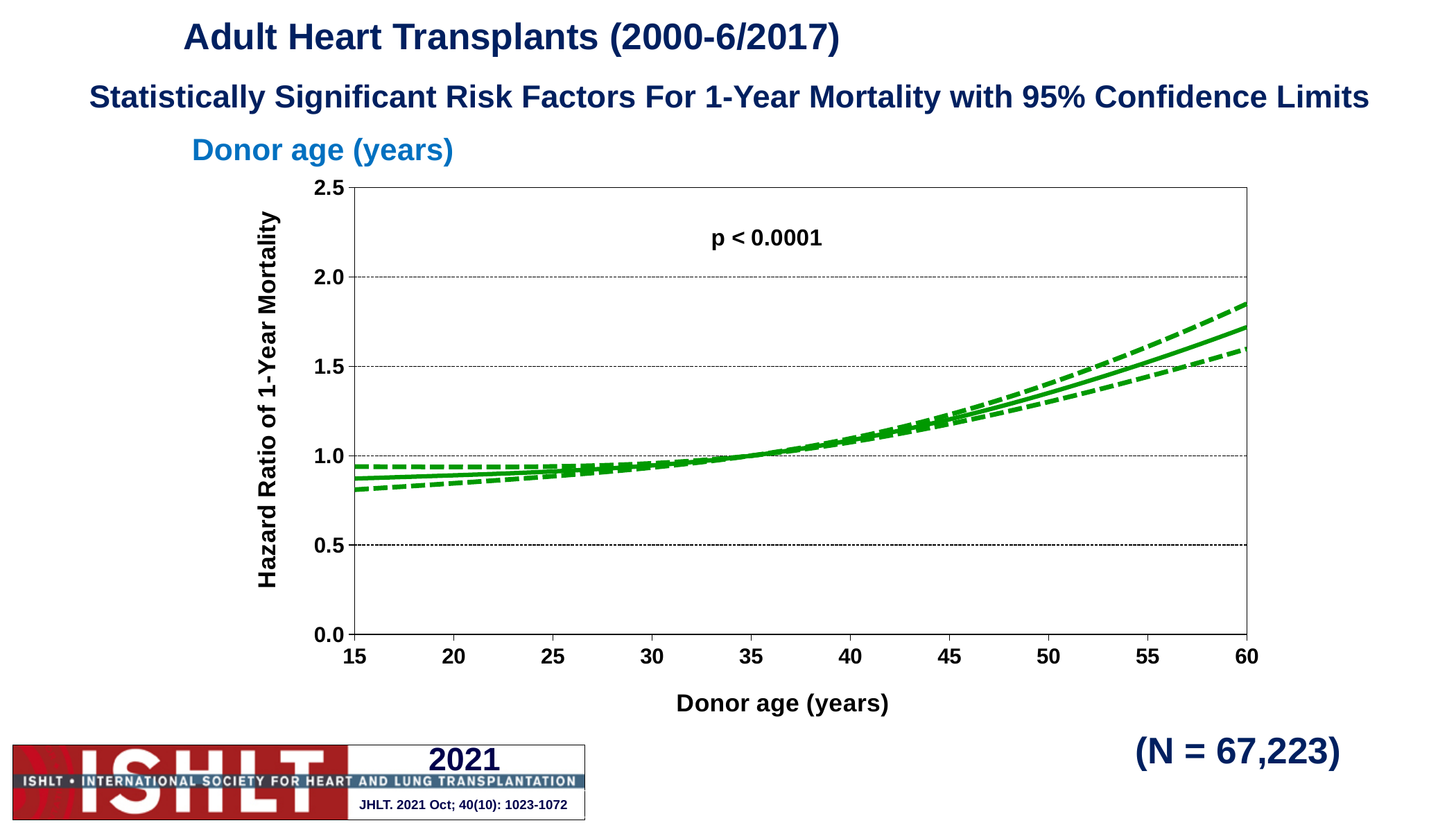
Is the hazard ratio for a donor age of 60 years greater or less than 2.0? less How many lines (solid and dashed) are plotted on the chart? 3 Is the hazard ratio for a donor age of 15 years greater or less than 1.0? less Which donor age has the higher hazard ratio, 20 years or 55 years? 55 years What is the label of the y axis? Hazard Ratio of 1-Year Mortality Is the hazard ratio for a donor age of 25 years greater or less than 1.0? less What is the highest donor age shown on the x axis? 60 Does the hazard ratio of 1-year mortality rise or fall as donor age increases from 15 to 60 years? rise What p-value is printed on the chart? p < 0.0001 What kind of chart is shown on the slide? line chart